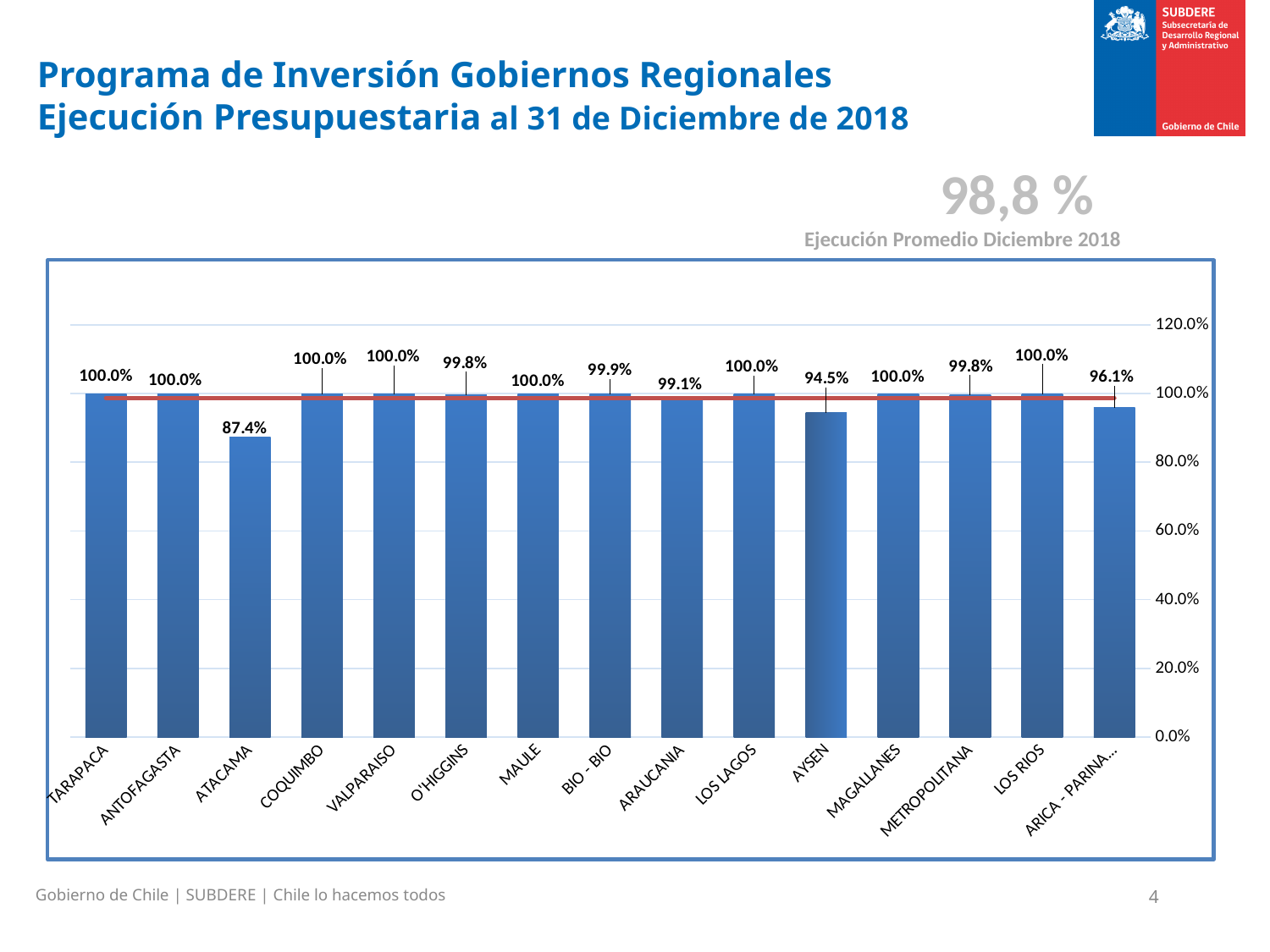
What is the value for ATACAMA? 87.4% What is the value for METROPOLITANA? 99.8% What average execution value is printed above the chart? 98,8 % How many regions are shown on the x axis? 15 What kind of chart is shown on the slide? bar chart What is the value for ARAUCANIA? 99.1% Which is larger, the value for AYSEN or the value for ARAUCANIA? ARAUCANIA What is the value for AYSEN? 94.5% What is the difference between the values for AYSEN and ATACAMA? 7.1% Is the value for ATACAMA greater or less than 100.0%? less Which region has the lowest value? ATACAMA What is the value for BIO - BIO? 99.9%